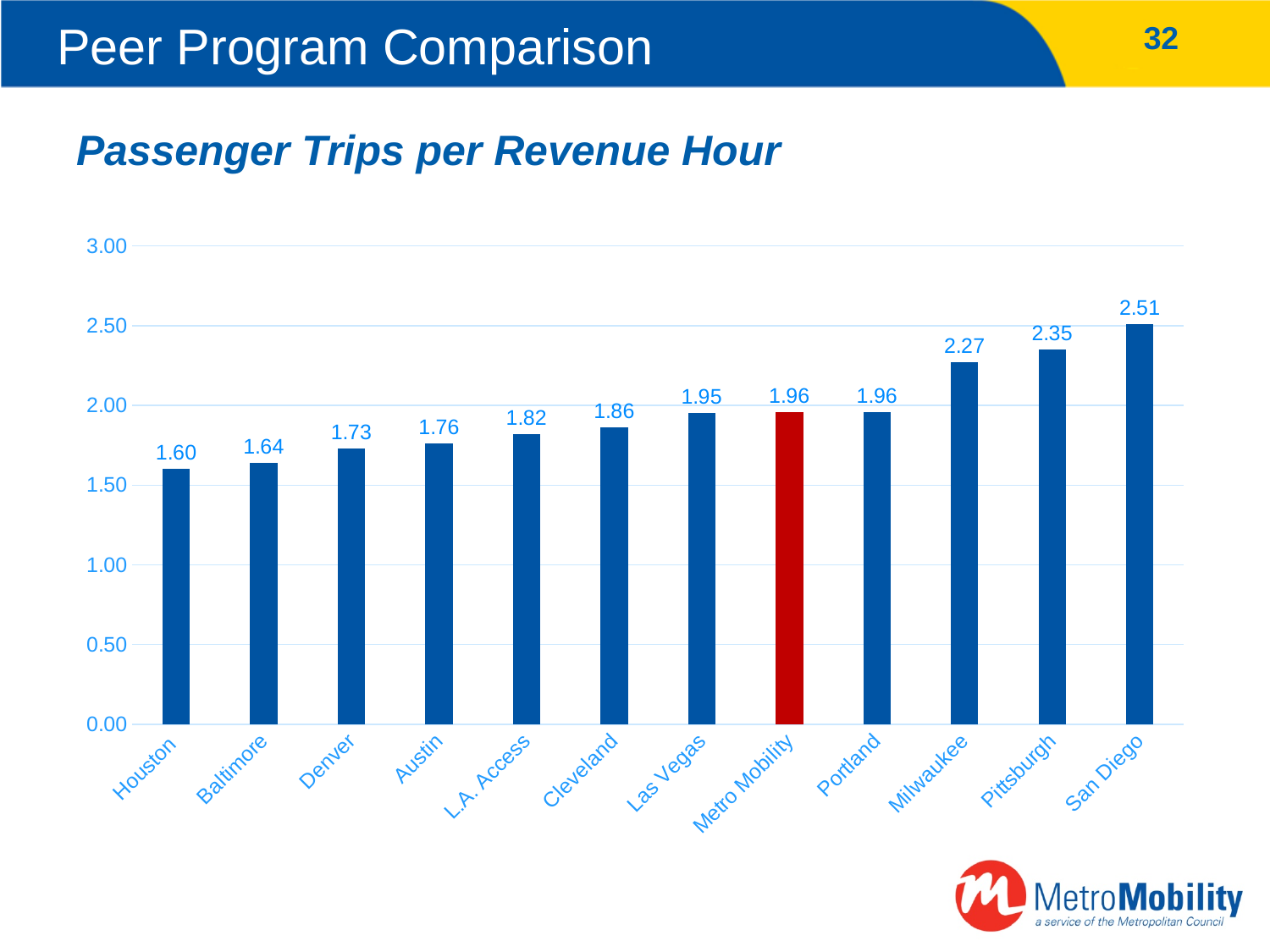
What kind of chart is shown on the slide? bar chart Which is larger, the value for Cleveland or the value for Denver? Cleveland What is the difference between San Diego and Houston? 0.91 What is the value for Milwaukee? 2.27 Which bar is highlighted in red? Metro Mobility What is the value for Metro Mobility? 1.96 Which city has the highest passenger trips per revenue hour? San Diego What is the value for Houston? 1.60 What is the difference between Pittsburgh and Milwaukee? 0.08 Is the value for Austin greater or less than 2.00? less How many cities or programs are shown on the chart? 12 Which city has the lowest passenger trips per revenue hour? Houston